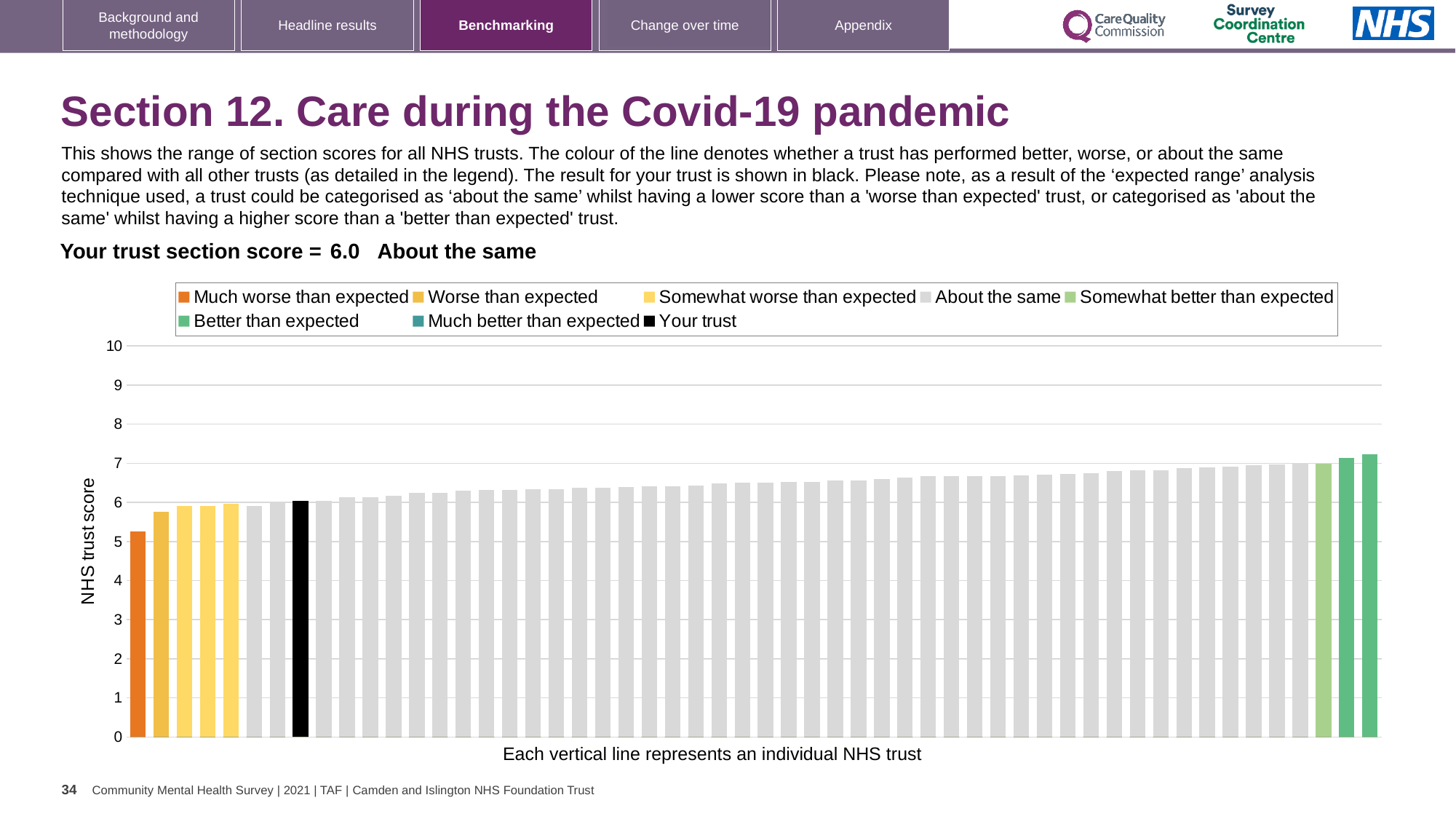
How many entries does the chart legend list? 8 What is the section score for your trust? 6.0 What is the label on the vertical axis of the chart? NHS trust score How many bars are coloured as 'Better than expected'? 2 Which benchmarking category is your trust placed in for this section? About the same Is the value of the highest bar on the chart greater or less than 6? greater How many bars are coloured as 'Much worse than expected'? 1 What kind of chart is shown on the slide? bar chart Is the value of the lowest bar on the chart greater or less than 5? greater Is the value of the lowest bar (the 'Much worse than expected' trust) greater or less than 6? less Do the bar values rise or fall from left to right along the x axis? rise